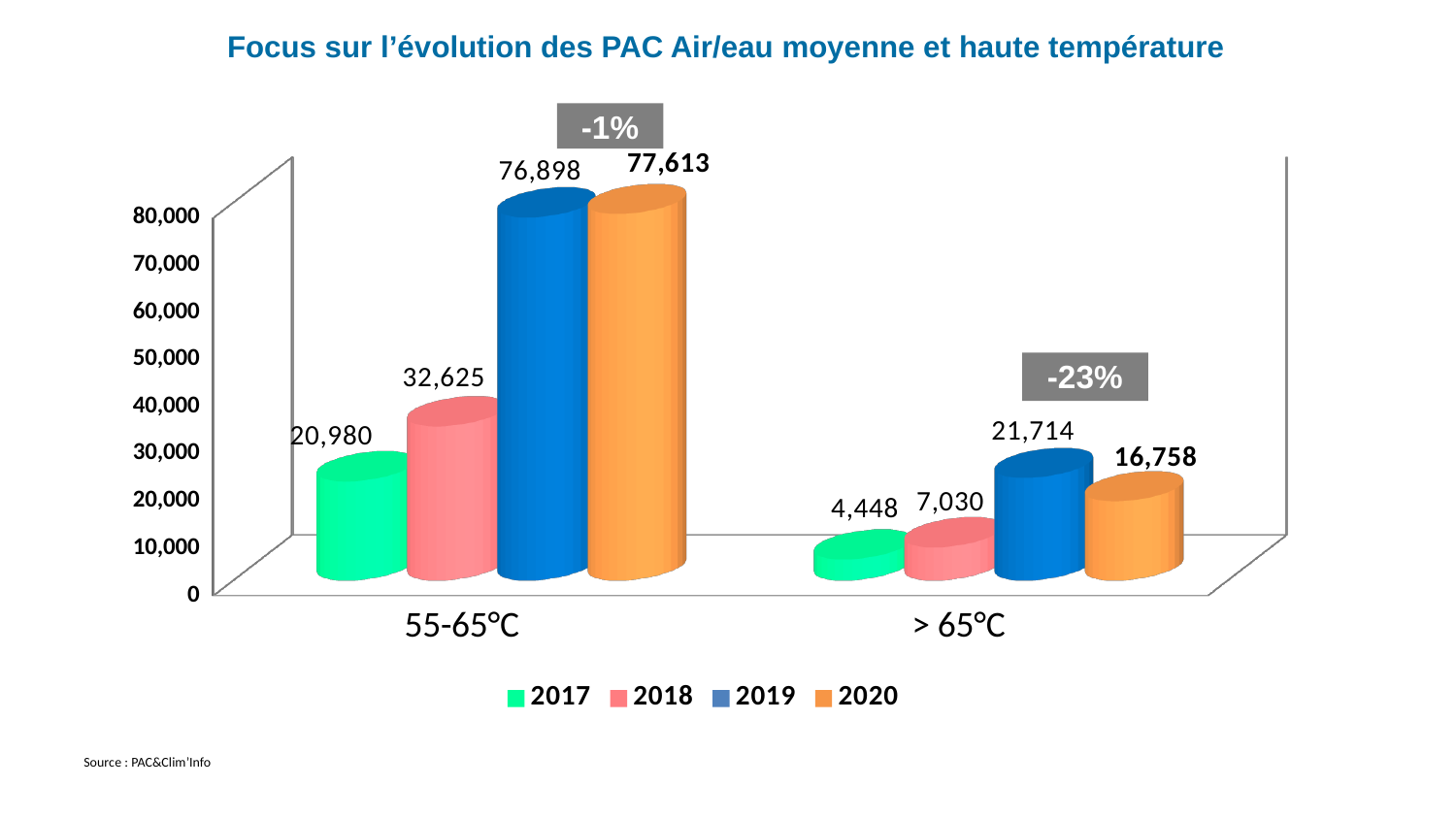
What is the difference between the 2019 and 2020 values in the > 65°C category? 4,956 What is the value for 2017 in the 55-65°C category? 20,980 Which year has the lowest value in the > 65°C category? 2017 How many categories are shown on the x axis? 2 What kind of chart is shown on the slide? Bar chart What is the value for 2019 in the 55-65°C category? 76,898 Which year has the highest value in the 55-65°C category? 2020 What is the value for 2020 in the > 65°C category? 16,758 How many series does the legend list? 4 Which is larger in the 55-65°C category: the 2018 value or the 2017 value? 2018 What is the value for 2018 in the > 65°C category? 7,030 What percentage change is annotated above the > 65°C category? -23%